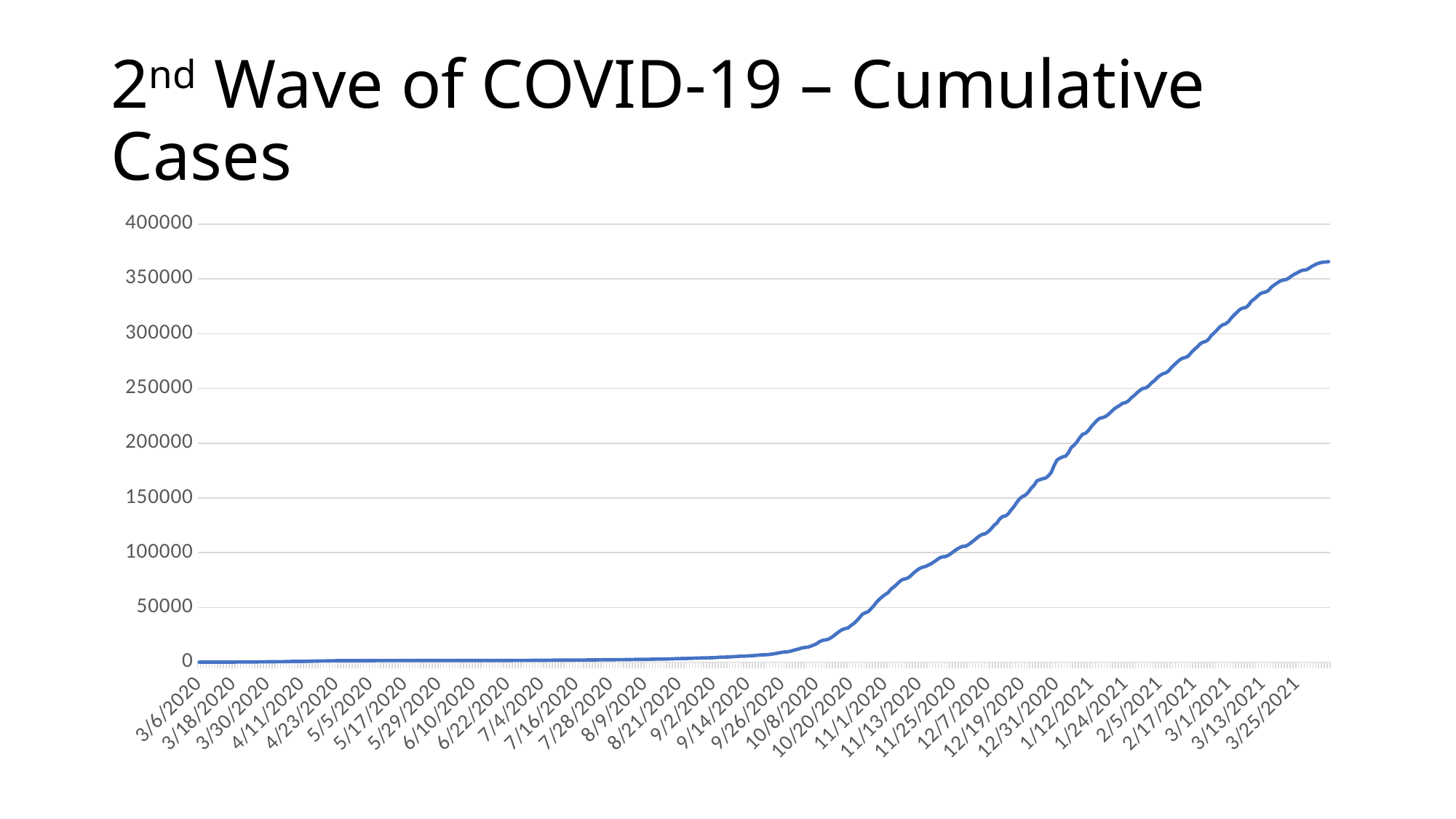
What is the title of the slide containing the chart? 2nd Wave of COVID-19 – Cumulative Cases Is the value for 12/31/2020 greater or less than 150000? greater Is the value for 6/10/2020 greater or less than 50000? less Is the value for 11/1/2020 greater or less than 50000? greater What is the highest value shown on the y axis of the chart? 400000 What kind of chart is shown on the slide? line chart Do the cumulative case values rise or fall along the x axis from 3/6/2020 to 3/25/2021? rise